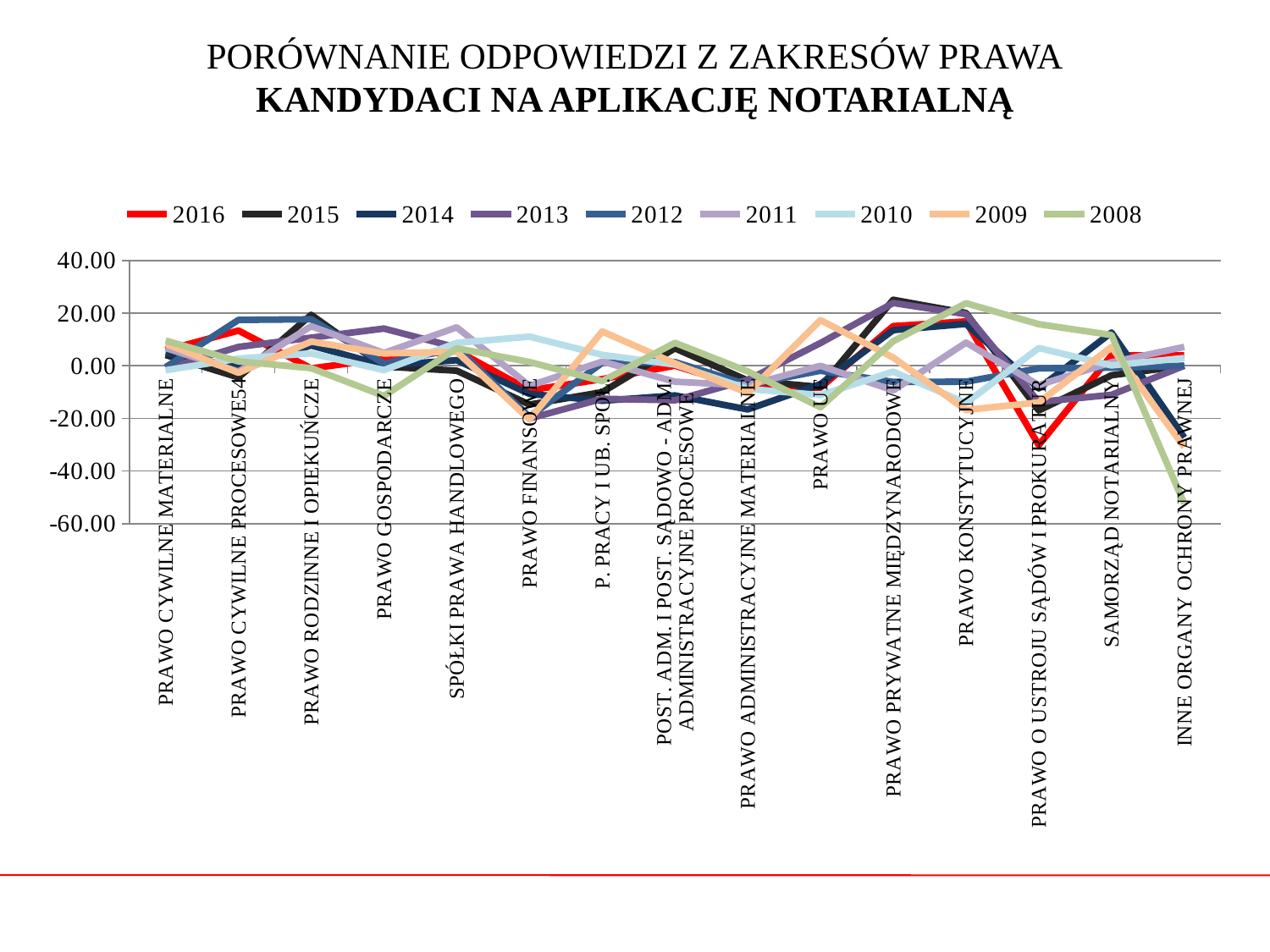
At INNE ORGANY OCHRONY PRAWNEJ, which series has the larger value: 2008 or 2016? 2016 Is the value for 2013 at PRAWO PRYWATNE MIĘDZYNARODOWE greater or less than 20? greater How many categories are plotted along the x axis? 15 Which year is shown in red in the legend? 2016 For the 2008 series, which category has the lowest value? INNE ORGANY OCHRONY PRAWNEJ Is the value for 2008 at INNE ORGANY OCHRONY PRAWNEJ greater or less than -40? less Is the value for 2014 at PRAWO ADMINISTRACYJNE MATERIALNE greater or less than 0? less What kind of chart is shown on the slide? line chart For the 2016 series, which category has the lowest value? PRAWO O USTROJU SĄDÓW I PROKURATUR How many series does the legend list? 9